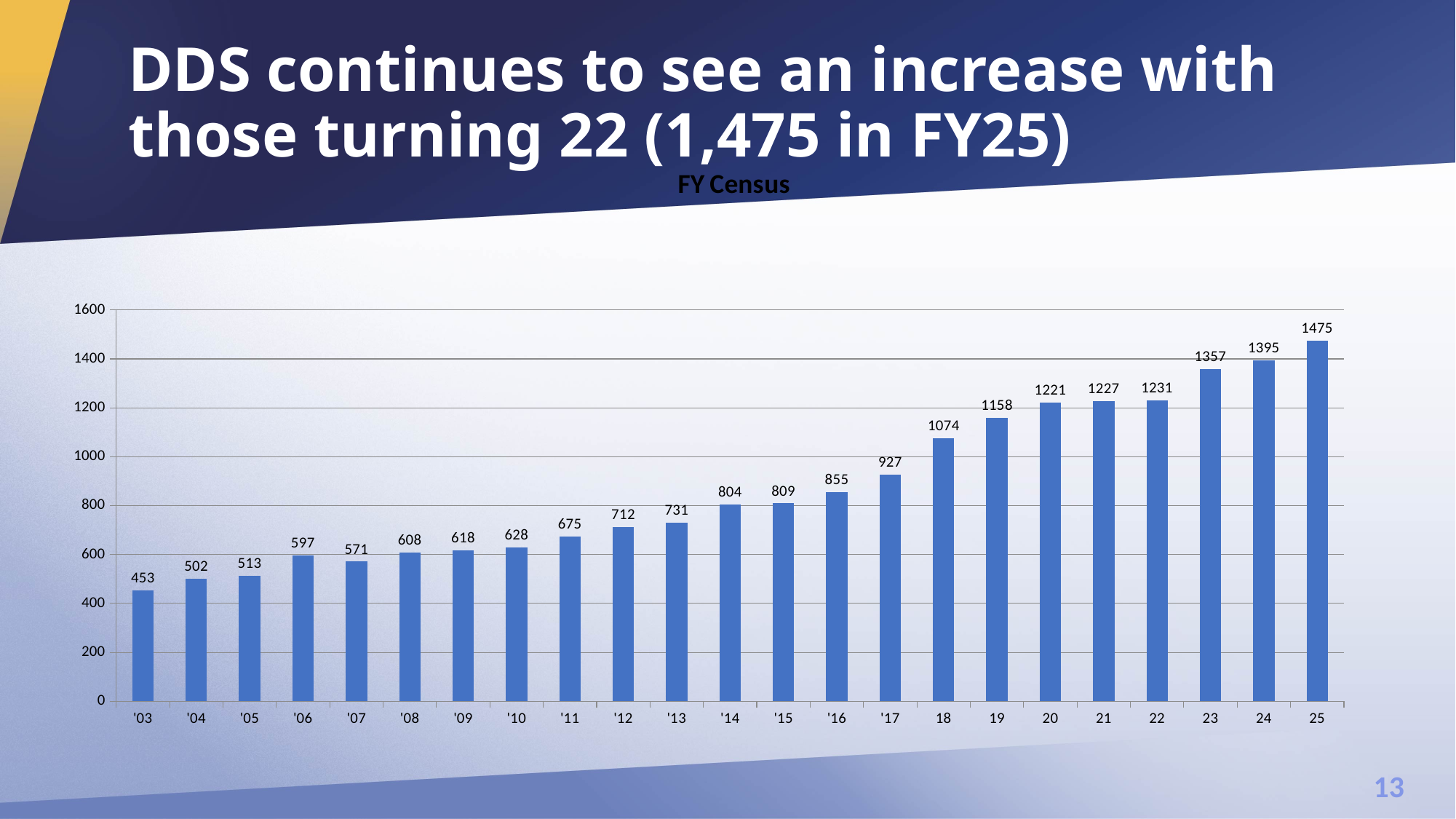
What is the difference between the values for '17 and '16 in the FY Census chart? 72 What is the difference between the values for 25 and 24 in the FY Census chart? 80 What is the value for '12 in the FY Census chart? 712 Do the values in the FY Census chart generally rise or fall from '03 to 25? rise Is the value for 23 greater or less than 1200 in the FY Census chart? greater What is the value for 18 in the FY Census chart? 1074 How many years are shown on the x axis of the FY Census chart? 23 Which year has the lowest value in the FY Census chart? '03 Which is larger in the FY Census chart, the value for '06 or the value for '07? '06 What kind of chart is the FY Census chart? bar chart What is the value for '03 in the FY Census chart? 453 Which year has the highest value in the FY Census chart? 25